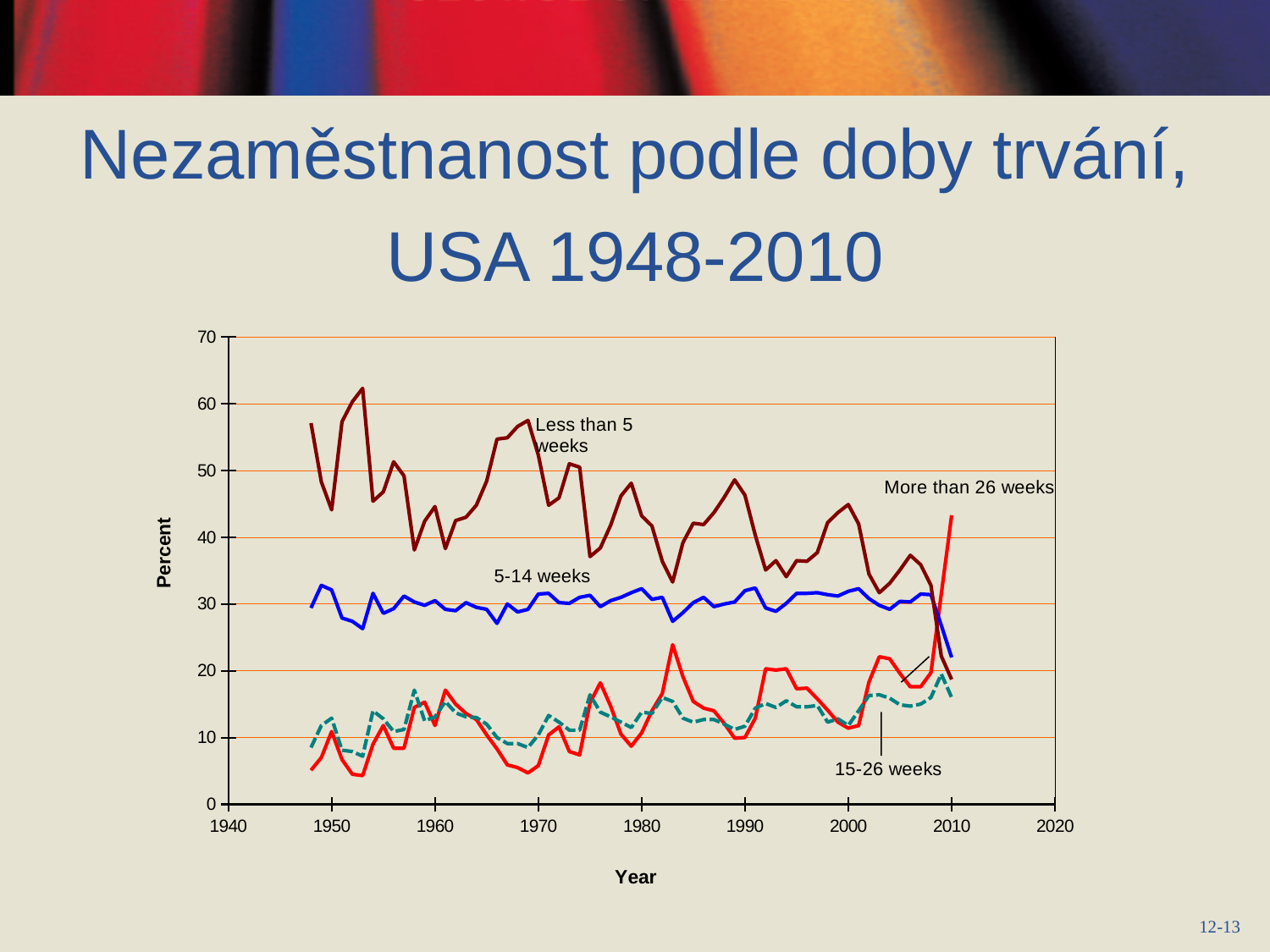
Which series has the lowest value around 1950? More than 26 weeks Is the value for More than 26 weeks in 2010 greater or less than 40? greater What is the label of the horizontal axis? Year Which series has the highest values for most of the period shown? Less than 5 weeks In 2010, which series is higher: More than 26 weeks or Less than 5 weeks? More than 26 weeks What kind of chart is shown on the slide? line chart How many data series are labelled on the chart? 4 What is the label of the vertical axis? Percent Is the value for Less than 5 weeks in 1948 greater or less than 50? greater Is the value for More than 26 weeks in 1953 greater or less than 10? less Does the More than 26 weeks series generally rise or fall from 1948 to 2010? rise Does the Less than 5 weeks series generally rise or fall from 1948 to 2010? fall